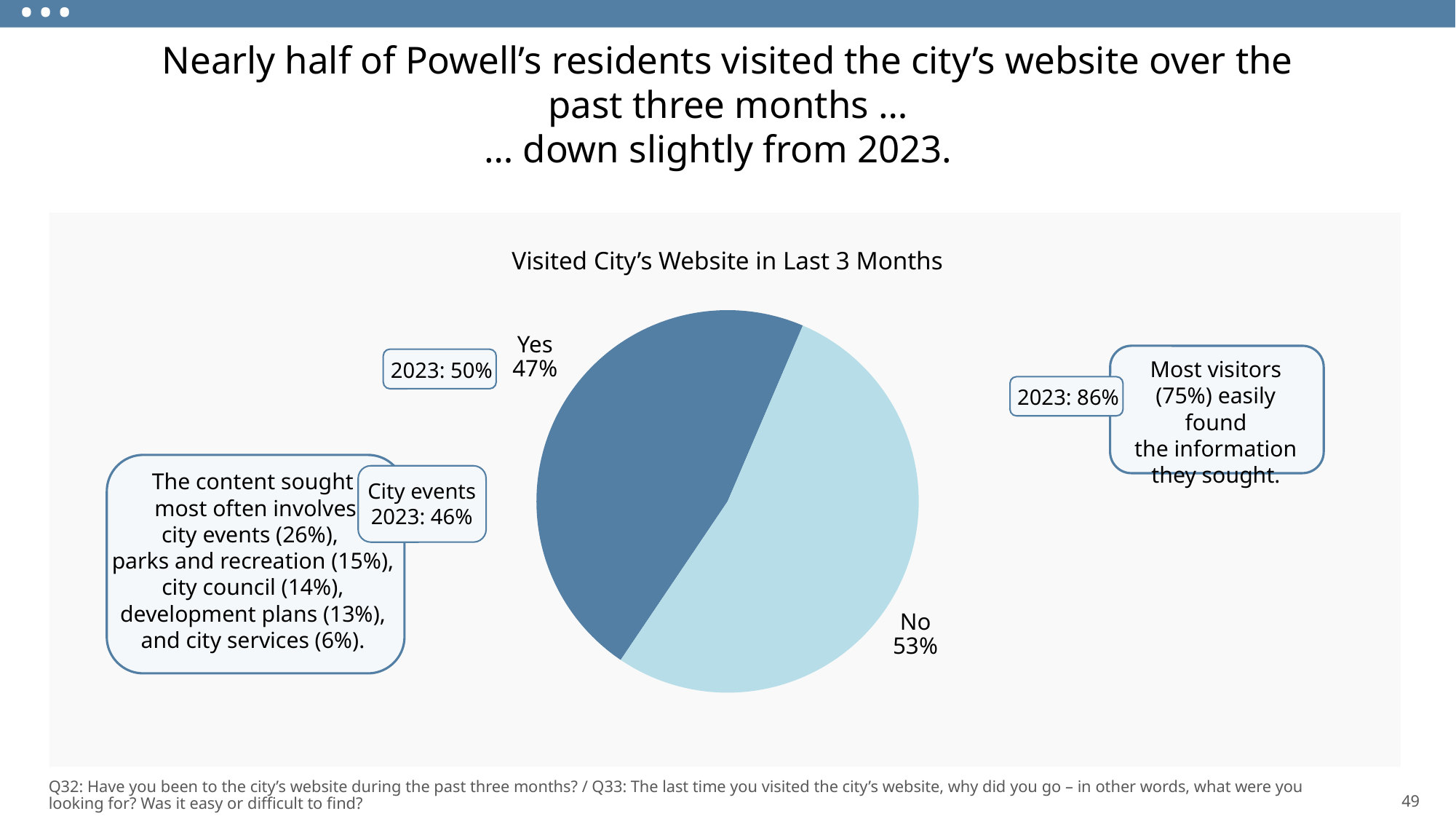
How many slices does the pie chart have? 2 Which category has the smallest share in the pie chart? Yes What percentage of respondents answered Yes in the Visited City's Website in Last 3 Months chart? 47% According to the callout next to the Yes slice, what was the Yes percentage in 2023? 50% Which category has the largest share in the pie chart? No What kind of chart is shown on the slide? Pie chart Which slice of the pie chart is larger, Yes or No? No Is the share of respondents who answered Yes greater or less than 50%? less What colour is the Yes slice of the pie chart? Dark blue What is the title of the chart? Visited City's Website in Last 3 Months What is the difference in percentage points between the No and Yes slices? 6 What percentage of respondents answered No in the Visited City's Website in Last 3 Months chart? 53%